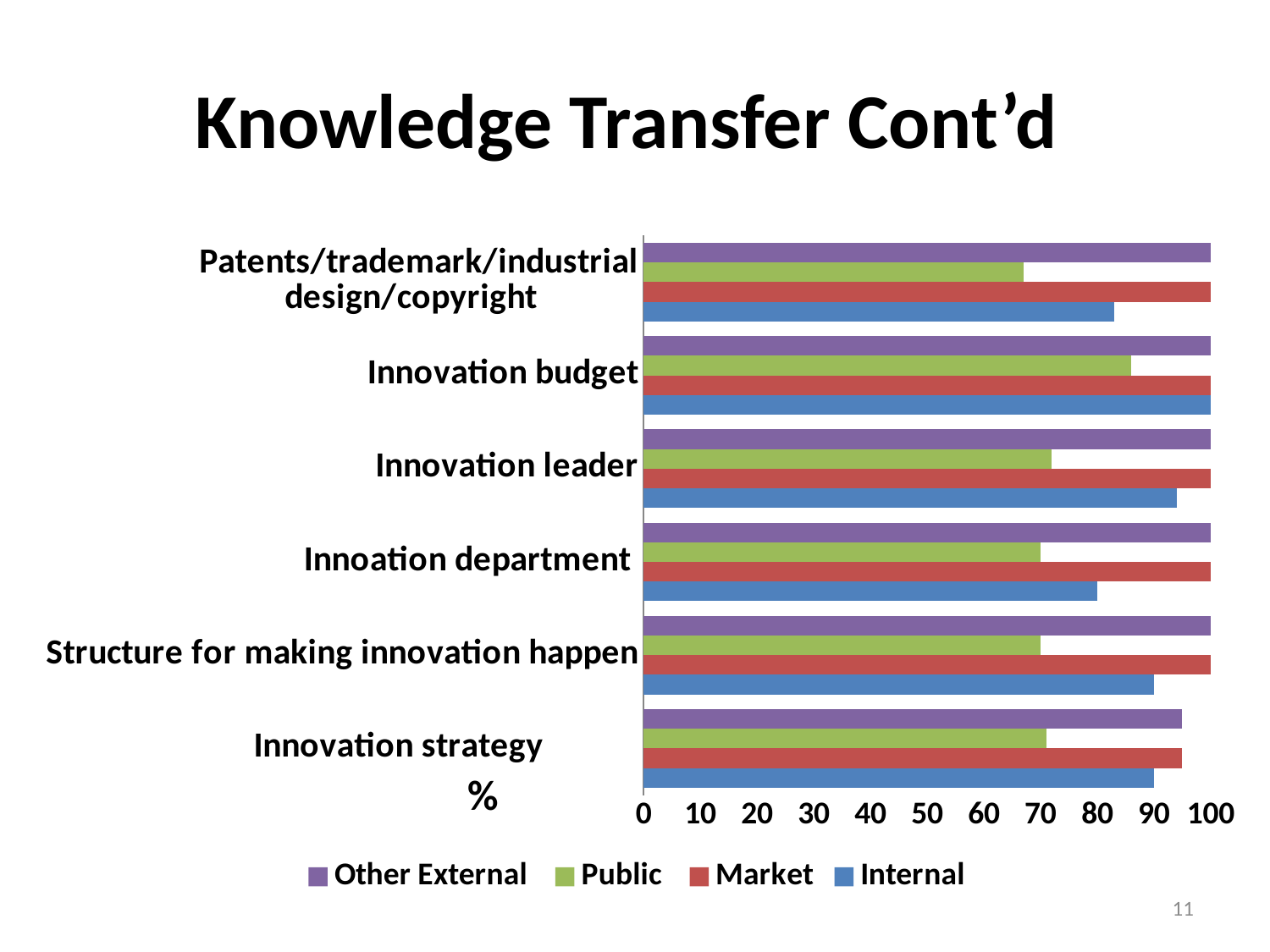
Is the Internal value for Innovation leader greater or less than 90? greater Which series is shown in green in the legend? Public What is the Market value for Innovation leader? 100 What is the Internal value for Innovation budget? 100 Which category has the highest Public value? Innovation budget What is the Internal value for Innovation strategy? 90 How many series does the legend list? 4 Is the Public value for Patents/trademark/industrial design/copyright greater or less than 80? less Is the Internal value for Patents/trademark/industrial design/copyright greater or less than 90? less How many categories are shown on the chart? 6 What kind of chart is shown on the slide? bar chart For Innovation leader, which is larger: the Public value or the Market value? Market